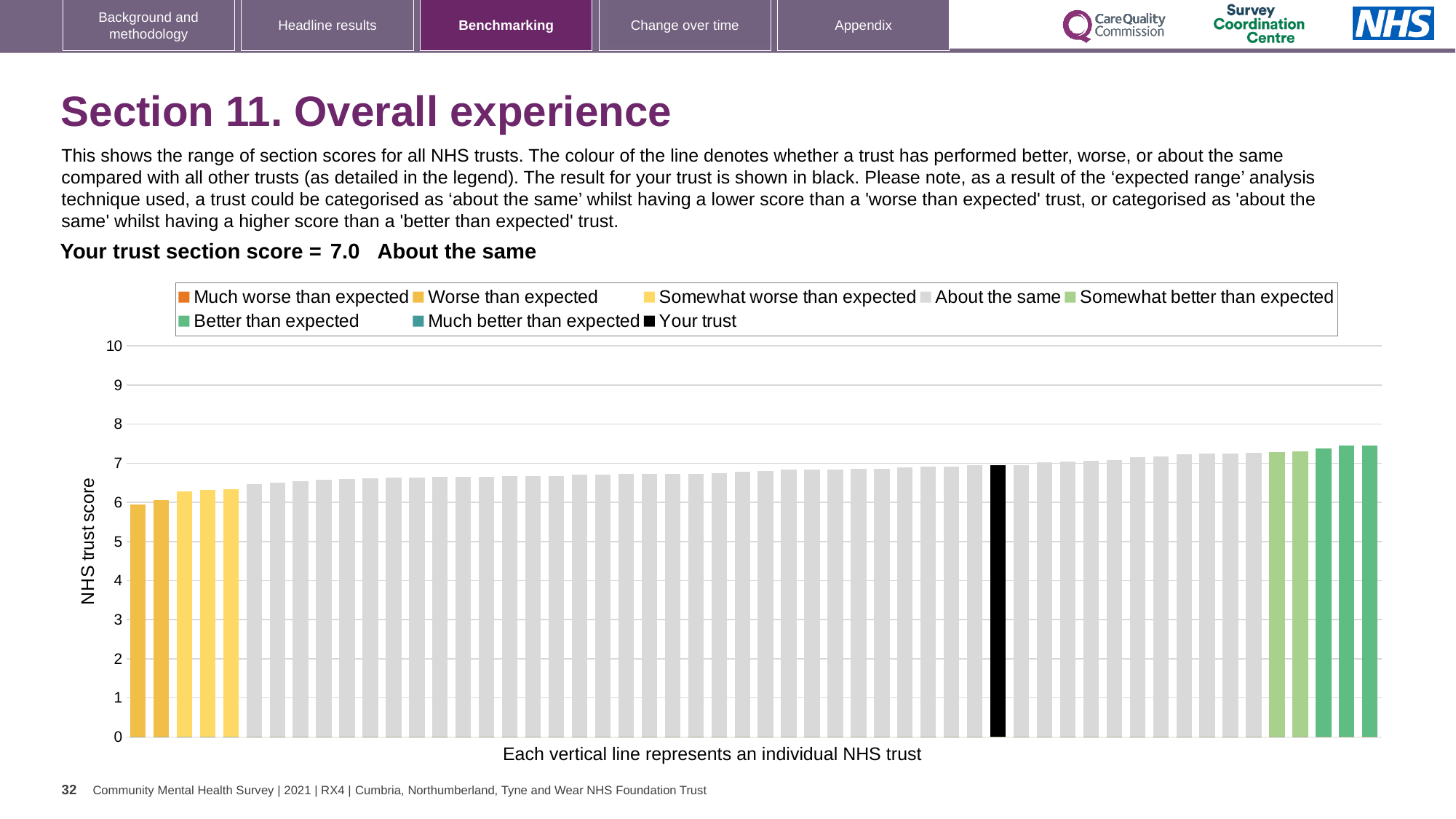
What is the highest value shown on the vertical axis? 10 What colour is the bar representing your trust? black Is the value of the tallest bar in the chart greater or less than 8? less Which category is your trust placed in for this section? About the same What kind of chart is shown on the slide? bar chart What is the label on the vertical axis of the chart? NHS trust score What is the section score for your trust shown on the slide? 7.0 How many entries does the chart legend list? 8 Is the value of the black 'Your trust' bar greater or less than 6? greater Do the bar values rise or fall from left to right along the x axis? rise Is the value of the leftmost bar in the chart greater or less than 7? less